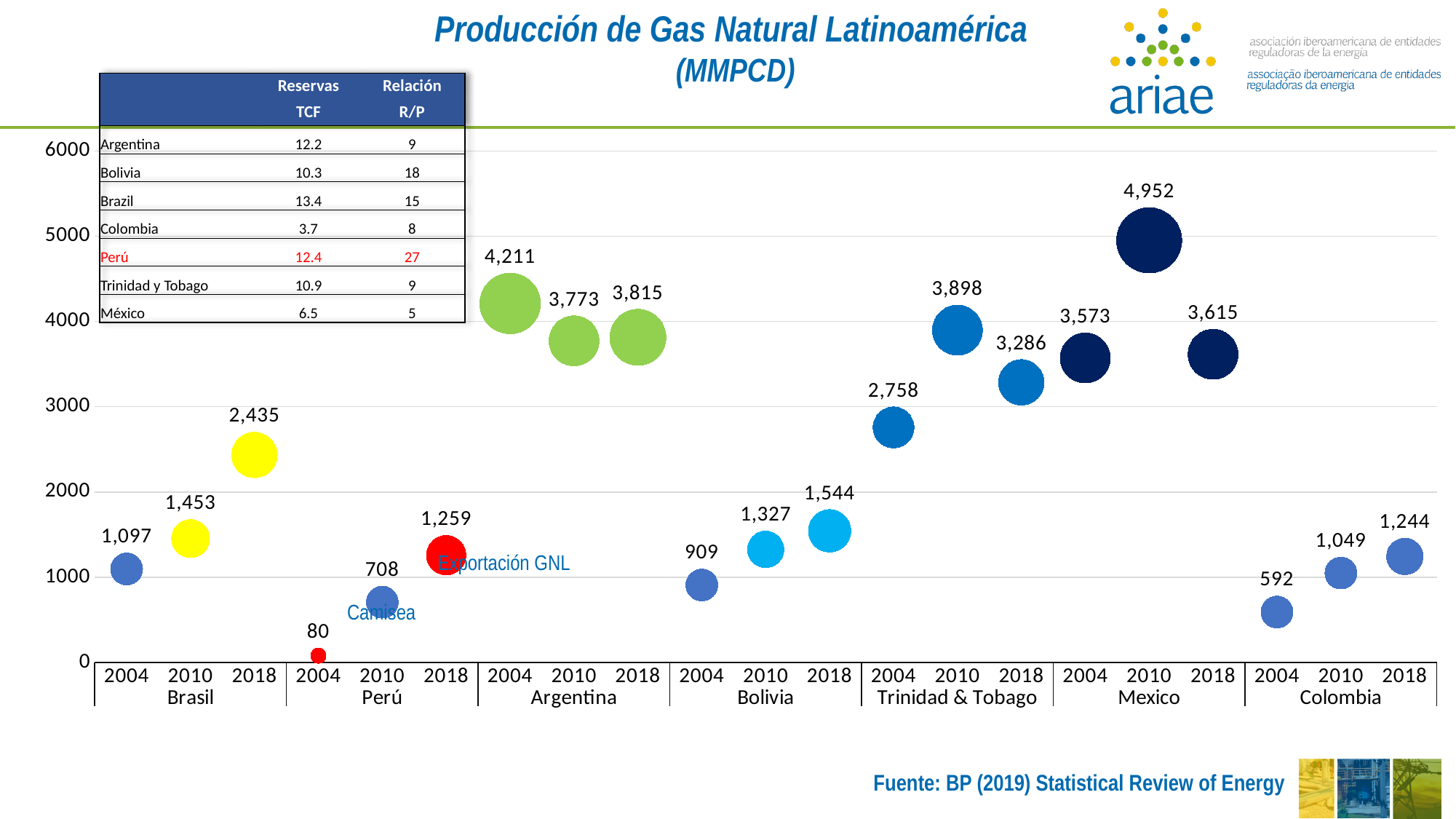
Which country and year has the lowest production value on the chart? Perú, 2004 What is the difference between Argentina's production in 2004 and in 2010? 438 Which is larger: Mexico's production in 2004 or Argentina's production in 2018? Argentina's production in 2018 What is the natural gas production value shown for Brasil in 2018? 2,435 Which country and year has the highest production value on the chart? Mexico, 2010 What is the production value shown for Colombia in 2004? 592 What is the difference between Bolivia's production in 2018 and in 2004? 635 Does Brasil's production rise or fall from 2004 to 2018? Rise What is the title of the chart? Producción de Gas Natural Latinoamérica (MMPCD) How many data points (bubbles) are plotted on the chart? 21 What is the production value shown for Trinidad & Tobago in 2010? 3,898 What is the production value shown for Perú in 2004? 80